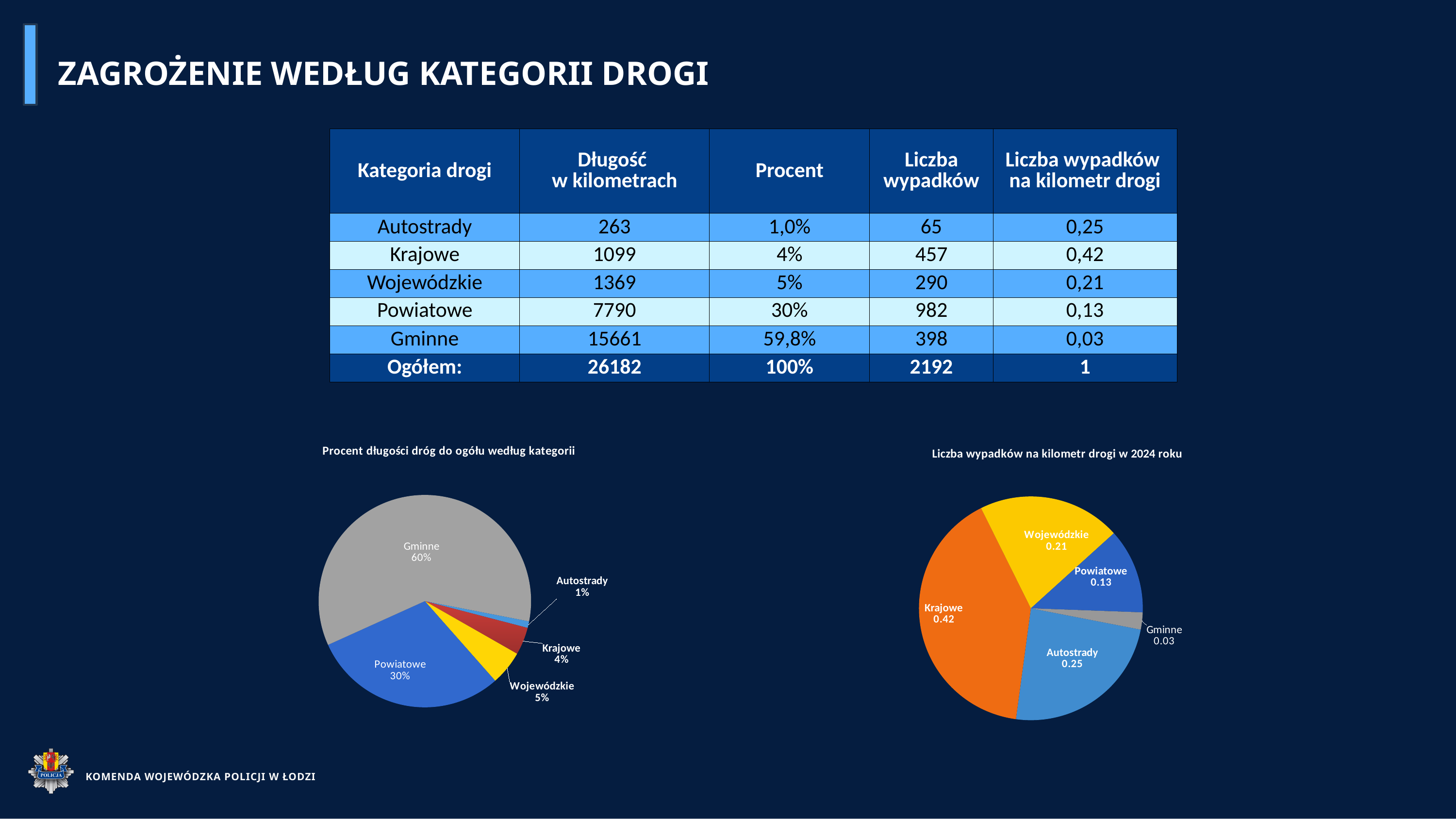
In the chart titled 'Procent długości dróg do ogółu według kategorii', which category has the largest slice? Gminne In the chart titled 'Liczba wypadków na kilometr drogi w 2024 roku', which is larger: Wojewódzkie or Powiatowe? Wojewódzkie In the chart titled 'Liczba wypadków na kilometr drogi w 2024 roku', what is the value for Krajowe? 0.42 In the chart titled 'Procent długości dróg do ogółu według kategorii', what percentage is shown for Powiatowe? 30% In the chart titled 'Procent długości dróg do ogółu według kategorii', what percentage is shown for Gminne? 60% What type of chart is 'Liczba wypadków na kilometr drogi w 2024 roku'? Pie chart In the chart titled 'Procent długości dróg do ogółu według kategorii', which category has the smallest slice? Autostrady In the chart titled 'Procent długości dróg do ogółu według kategorii', how many categories are shown? 5 In the chart titled 'Liczba wypadków na kilometr drogi w 2024 roku', which category has the lowest value? Gminne In the chart titled 'Procent długości dróg do ogółu według kategorii', what is the difference between the Gminne and Powiatowe percentages? 30% In the chart titled 'Liczba wypadków na kilometr drogi w 2024 roku', what is the difference between the Krajowe and Wojewódzkie values? 0.21 In the chart titled 'Liczba wypadków na kilometr drogi w 2024 roku', what is the value for Autostrady? 0.25